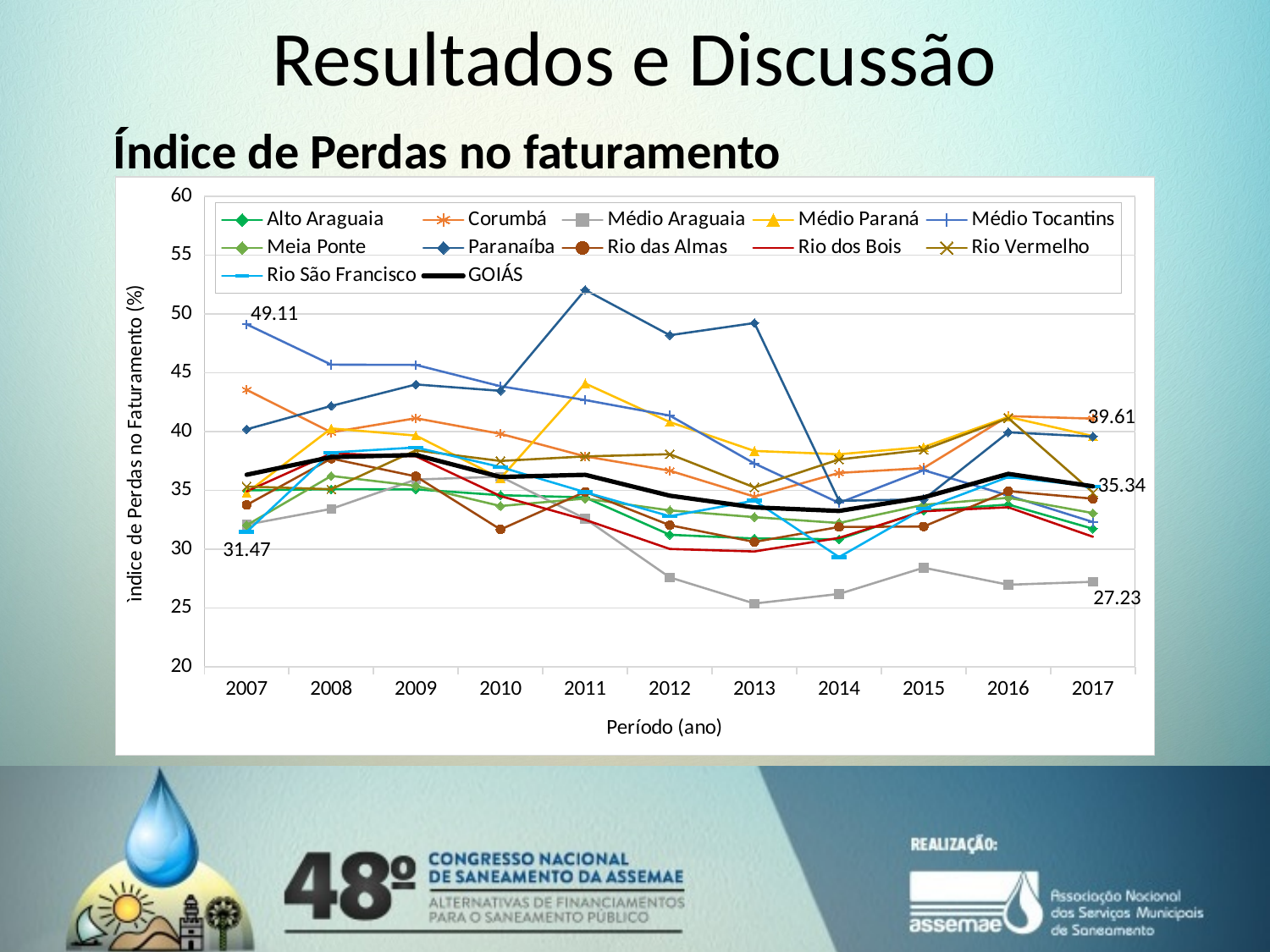
How many series does the legend list? 12 Is the value for Paranaíba in 2011 greater or less than 50? greater What is the difference between the GOIÁS value and the Médio Araguaia value in 2017? 8.11 What is the value for Médio Araguaia in 2017? 27.23 What is the value for GOIÁS in 2017? 35.34 Does the Médio Tocantins series rise or fall from 2007 to 2017? fall What is the value for Médio Tocantins in 2007? 49.11 What type of chart is shown on the slide? line chart Which series has the lowest value in 2017? Médio Araguaia How many years are shown on the x axis? 11 Is the value for Médio Araguaia in 2013 greater or less than 30? less Which series has the highest value in 2007? Médio Tocantins